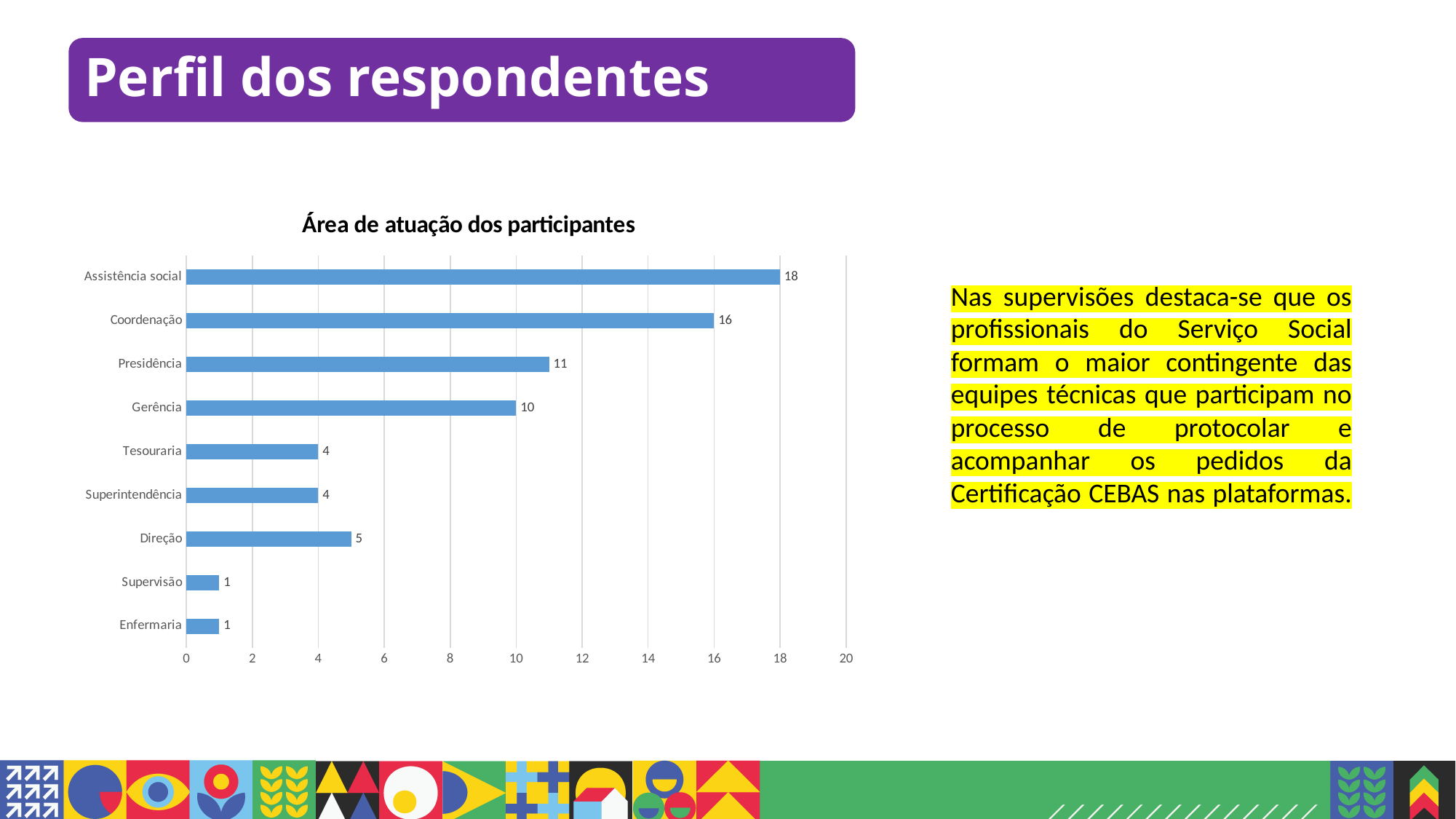
Is the value for Coordenação greater or less than 14? greater Which is larger, the value for Presidência or the value for Tesouraria? Presidência What is the title of the chart? Área de atuação dos participantes How many categories are shown in the chart? 9 What is the value for Superintendência? 4 What is the value for Direção? 5 What kind of chart is shown on the slide? bar chart What is the difference between the values for Assistência social and Enfermaria? 17 What is the value for Presidência? 11 Which category has the highest value? Assistência social What is the difference between the values for Coordenação and Gerência? 6 What is the value for Assistência social? 18